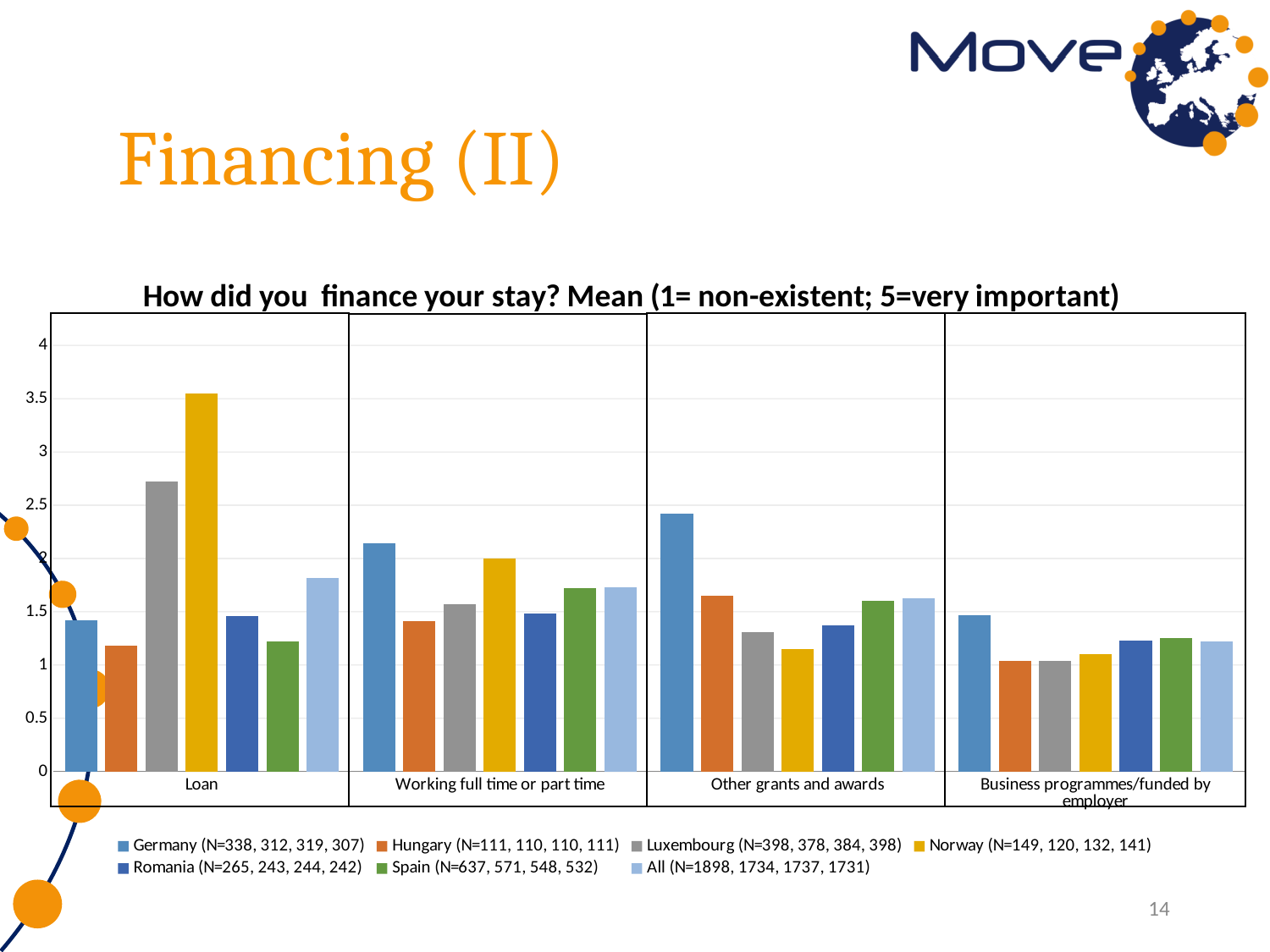
Is the value for Luxembourg in the Loan category greater or less than 2.5? greater In the Loan category, which country has the highest mean value? Norway How many financing categories are shown along the x axis? 4 What kind of chart is shown on the slide? bar chart How many series does the legend list? 7 For Norway, which is larger: the value for Loan or the value for Other grants and awards? Loan Is the value for Germany in the Other grants and awards category greater or less than 2? greater What is the title of the chart? How did you finance your stay? Mean (1= non-existent; 5=very important) In the Working full time or part time category, which is larger: the value for Germany or the value for Hungary? Germany In the Other grants and awards category, which country has the lowest mean value? Norway Is the value for Norway in the Loan category greater or less than 3? greater In the Other grants and awards category, which country has the highest mean value? Germany